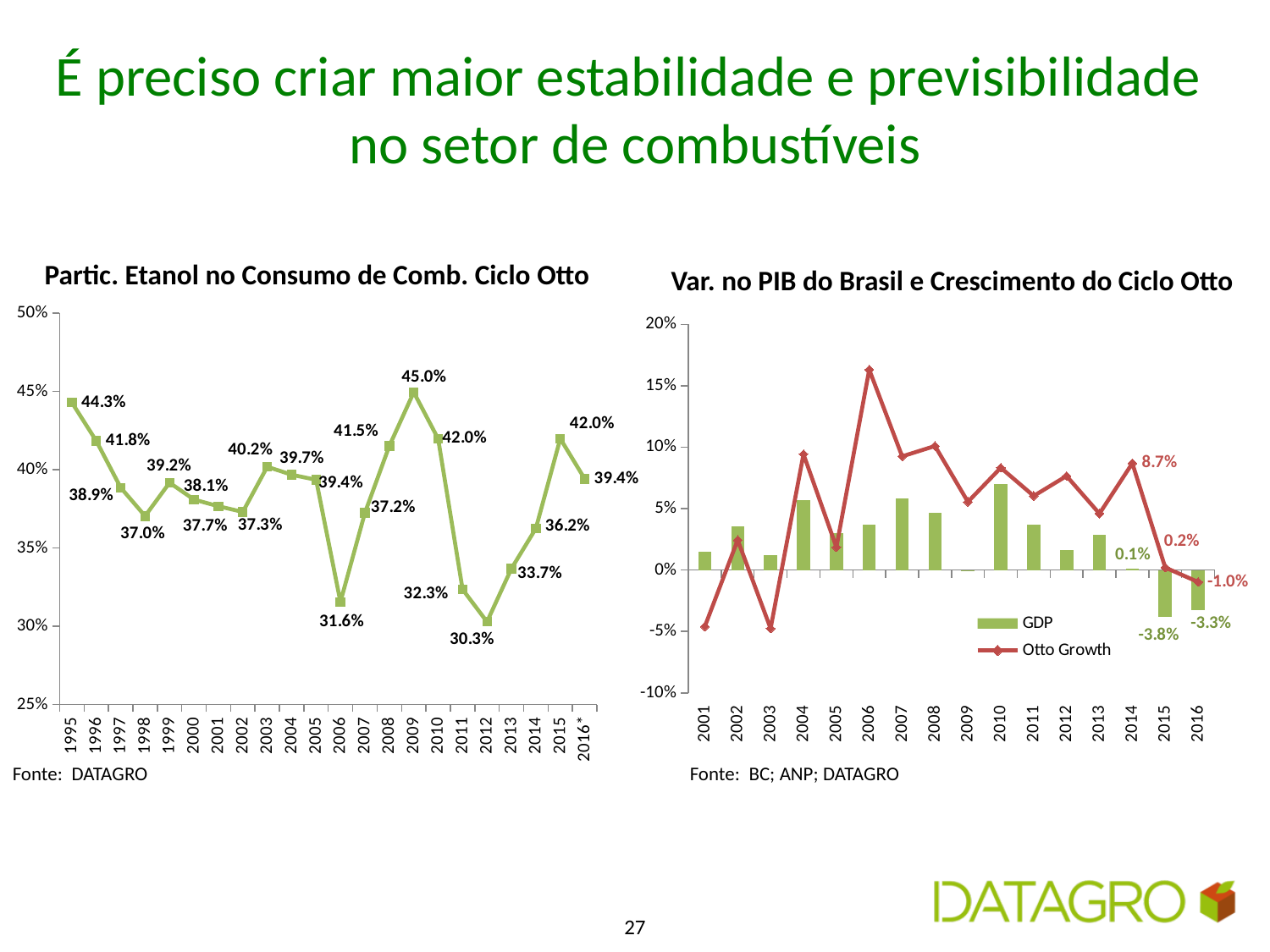
In the chart 'Partic. Etanol no Consumo de Comb. Ciclo Otto', how many years are plotted on the x axis? 22 In the chart 'Var. no PIB do Brasil e Crescimento do Ciclo Otto', how many series does the legend list? 2 In the chart 'Partic. Etanol no Consumo de Comb. Ciclo Otto', which year has the highest value? 2009 In the chart 'Partic. Etanol no Consumo de Comb. Ciclo Otto', what is the difference between the 2015 value and the 2016* value? 2.6 percentage points In the chart 'Partic. Etanol no Consumo de Comb. Ciclo Otto', what is the value for 2009? 45.0% In the chart 'Partic. Etanol no Consumo de Comb. Ciclo Otto', which year has the lowest value? 2012 In the chart 'Partic. Etanol no Consumo de Comb. Ciclo Otto', what is the value for 2006? 31.6% In the chart 'Var. no PIB do Brasil e Crescimento do Ciclo Otto', which is lower, the GDP value for 2015 or for 2016? 2015 In the chart 'Var. no PIB do Brasil e Crescimento do Ciclo Otto', is the Otto Growth value for 2006 greater or less than 15%? greater In the chart 'Partic. Etanol no Consumo de Comb. Ciclo Otto', do the values rise or fall from 2012 to 2015? rise In the chart 'Var. no PIB do Brasil e Crescimento do Ciclo Otto', what is the Otto Growth value for 2014? 8.7% In the chart 'Var. no PIB do Brasil e Crescimento do Ciclo Otto', what is the GDP value for 2015? -3.8%